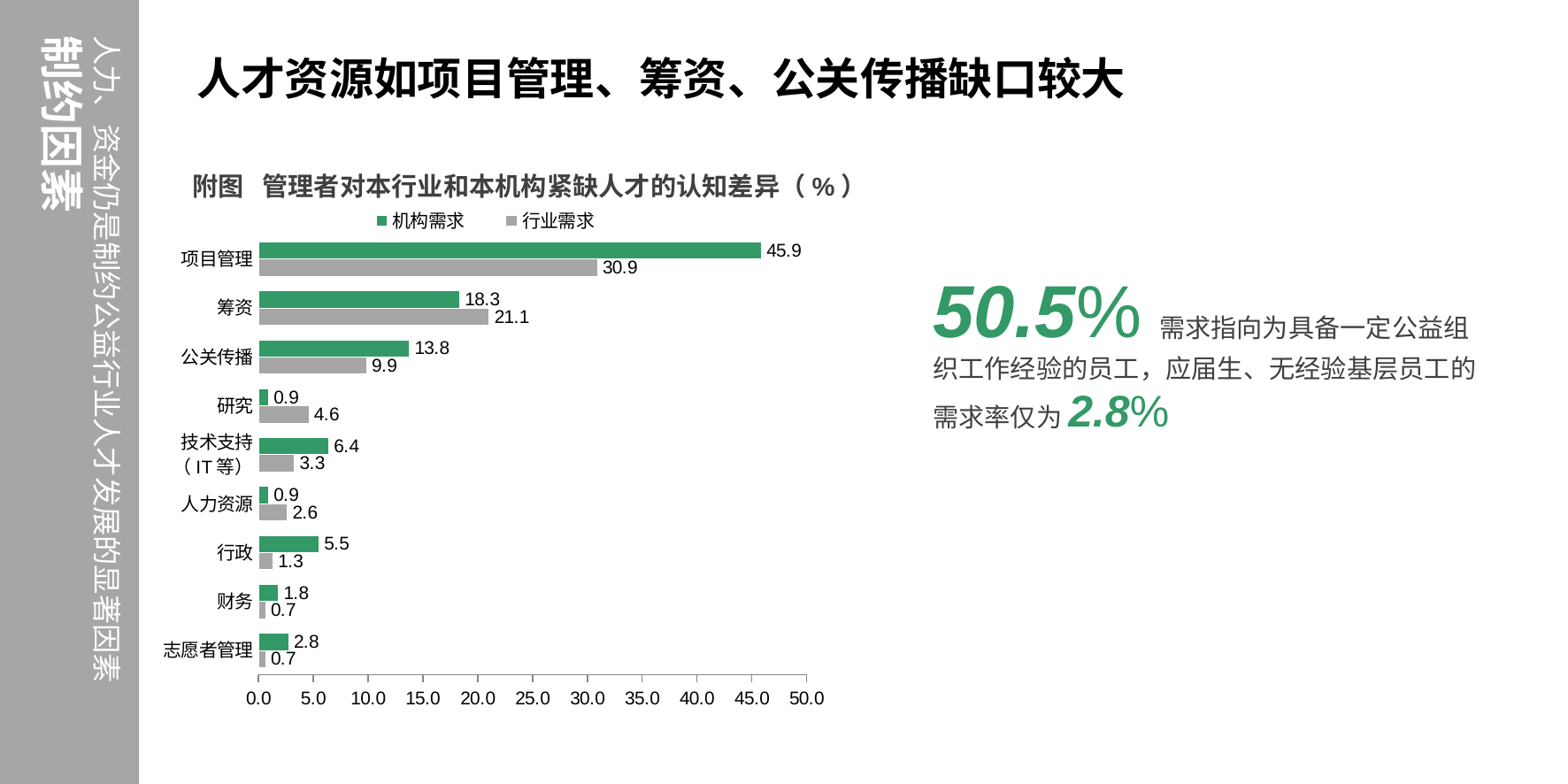
What kind of chart is shown on the slide? Bar chart For 筹资, which is larger: 机构需求 or 行业需求? 行业需求 What is the total of the 机构需求 and 行业需求 values for 公关传播? 23.7 How many series does the legend list? 2 What is the 机构需求 value for 技术支持（IT等）? 6.4 Which category has the lowest 机构需求 value? 研究 and 人力资源 (both 0.9) What is the 行业需求 value for 筹资? 21.1 What is the difference between the 机构需求 and 行业需求 values for 项目管理? 15.0 Which category has the highest 行业需求 value? 项目管理 Which colour represents 机构需求 in the chart? Green What is the 机构需求 value for 项目管理? 45.9 How many categories are shown on the chart? 9